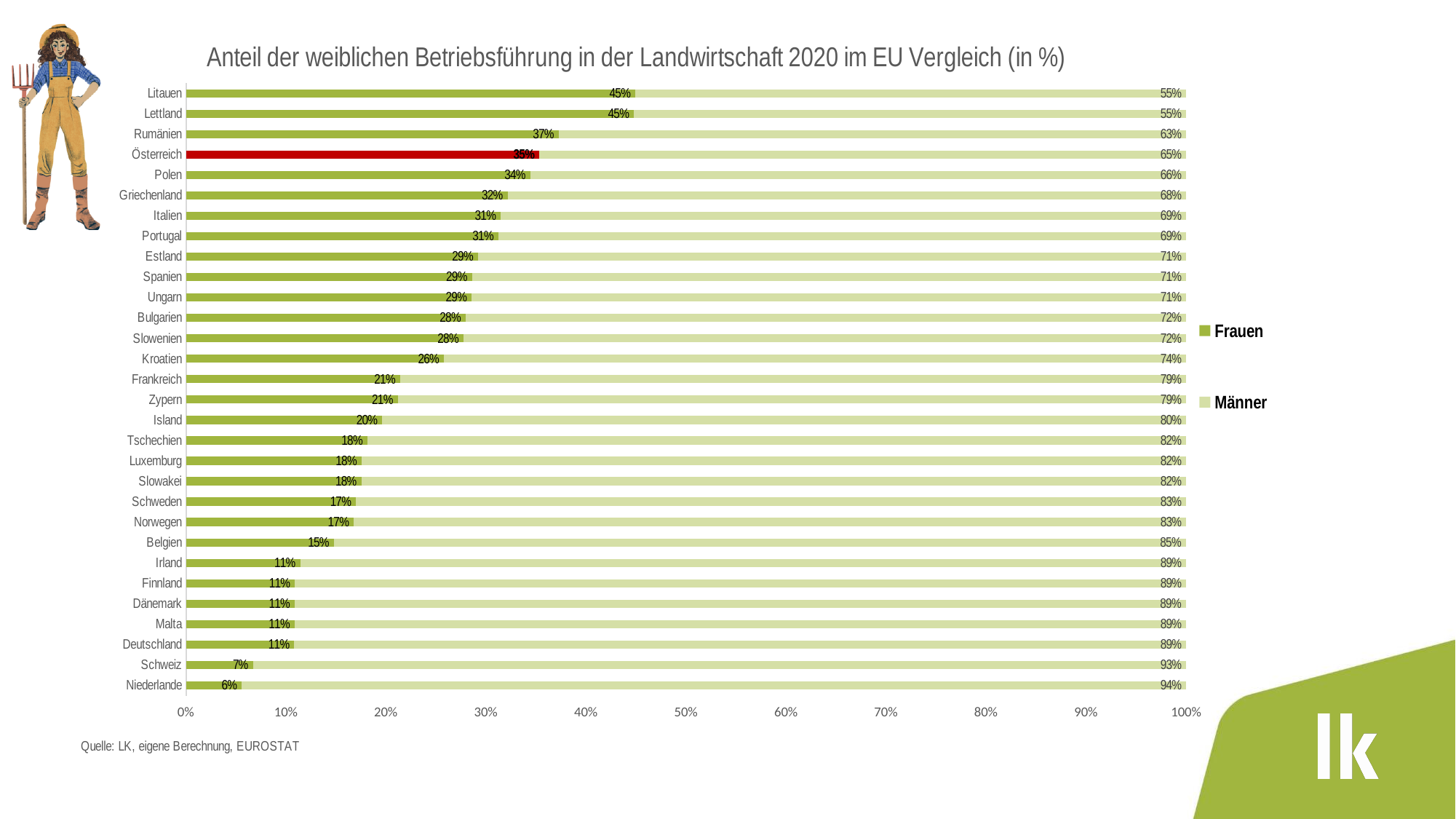
What is the Männer value for Deutschland? 89% Which country has the highest Männer value? Niederlande How many series does the legend list? 2 How many countries are shown in the chart? 30 Which has a larger Frauen value, Polen or Belgien? Polen What is the total of the Frauen and Männer values for Schweiz? 100% What kind of chart is shown on the slide? Bar chart What is the Frauen value for Rumänien? 37% What is the difference between the Frauen values for Österreich and Deutschland? 24% What is the Frauen value for Österreich? 35% Which country has the lowest Frauen value? Niederlande Which country's Frauen bar is highlighted in red? Österreich